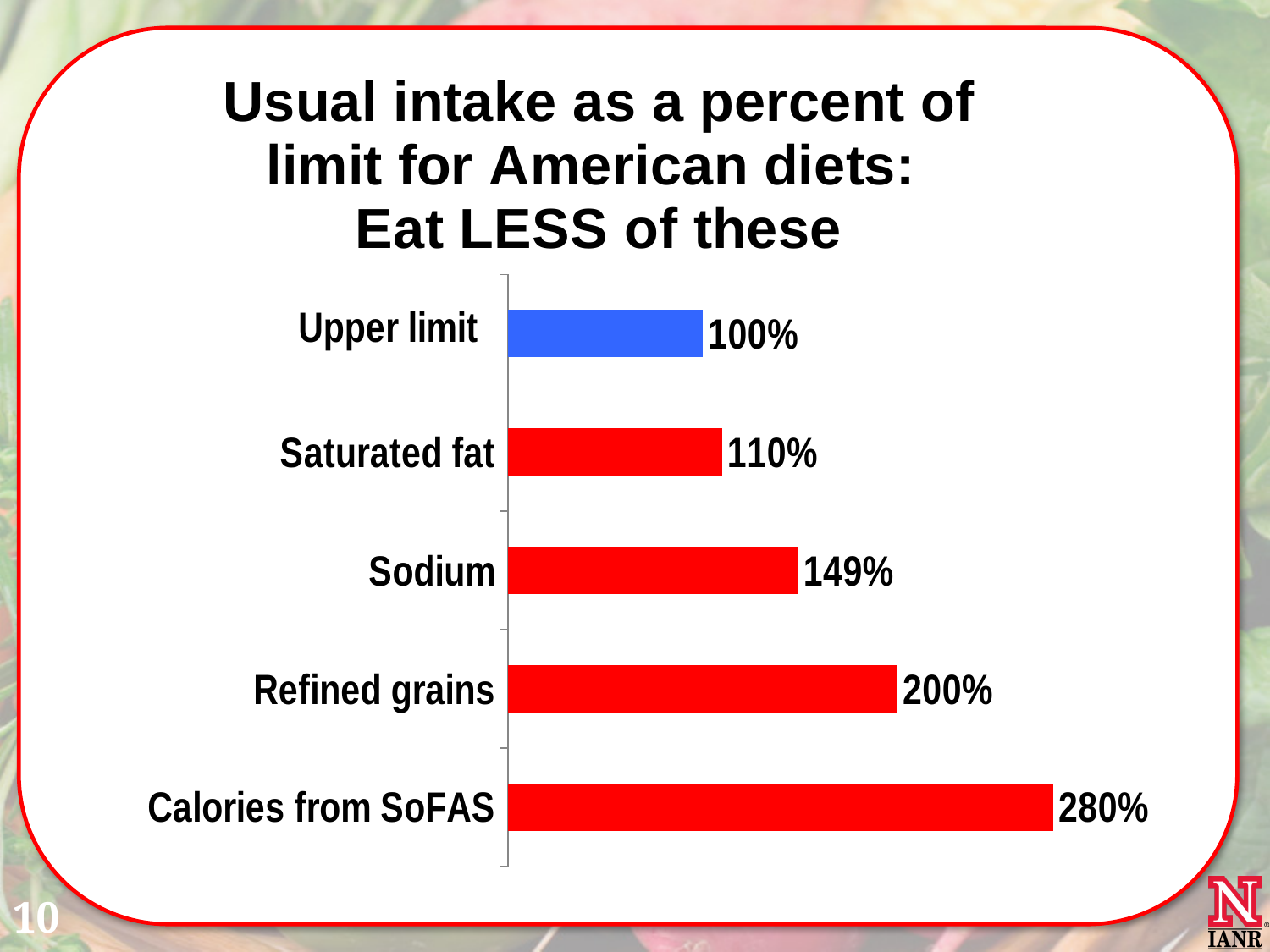
What is the value for Calories from SoFAS? 280% What kind of chart is shown on the slide? Bar chart What is the value for Saturated fat? 110% What is the difference between the values for Calories from SoFAS and Refined grains? 80% How many categories are shown in the chart? 5 Which is larger, the value for Sodium or the value for Refined grains? Refined grains Which category has the highest value? Calories from SoFAS What is the difference between the values for Sodium and Saturated fat? 39% What is the value for Sodium? 149% What is the value for Refined grains? 200% Which category has the lowest value? Upper limit Which bar is coloured blue rather than red? Upper limit